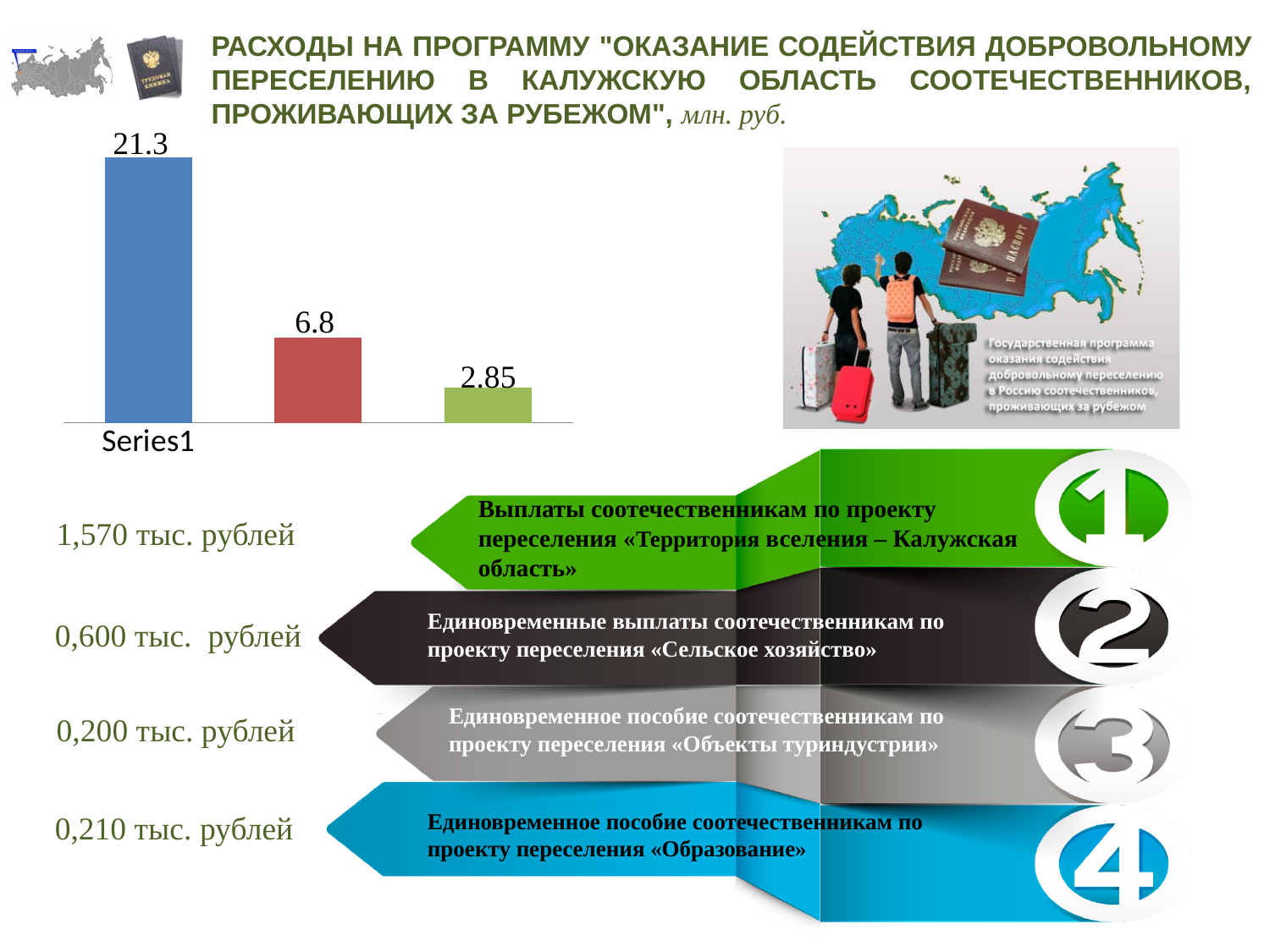
Which is larger, the value of the red bar or the value of the green bar? The red bar (6.8) What label appears on the x axis of the chart? Series1 What value is shown on the green (rightmost) bar of the chart? 2.85 Which bar in the chart has the highest value? The blue (leftmost) bar, 21.3 Do the bar values rise or fall from left to right across the chart? Fall What value is shown on the blue (leftmost) bar of the chart? 21.3 How many bars are plotted in the chart? 3 What is the difference between the blue bar (21.3) and the red bar (6.8)? 14.5 What value is shown on the red (middle) bar of the chart? 6.8 What type of chart is shown on the slide? Bar chart What is the difference between the red bar (6.8) and the green bar (2.85)? 3.95 Which bar in the chart has the lowest value? The green (rightmost) bar, 2.85